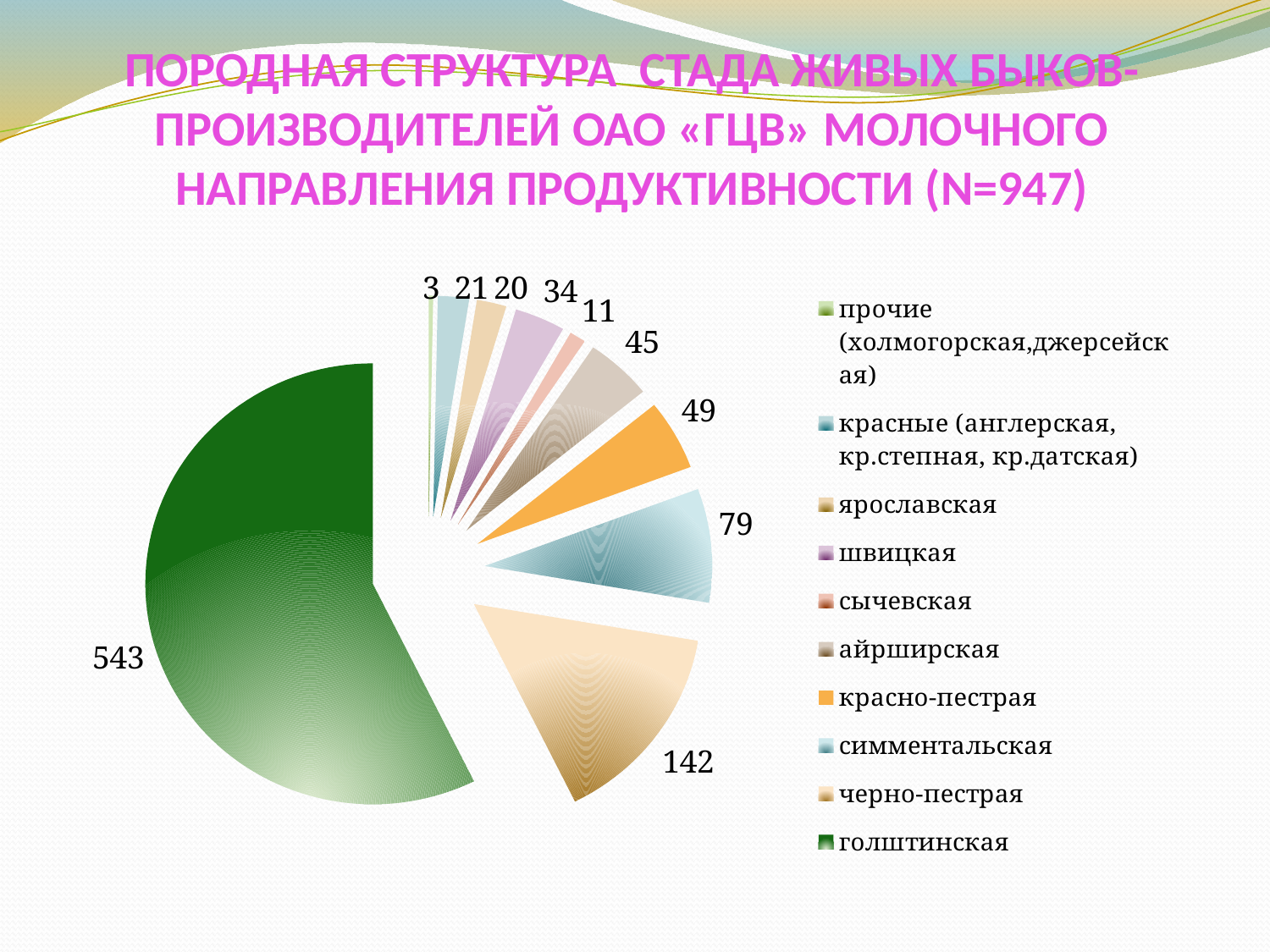
What type of chart is shown on the slide? pie chart What is the difference between the values for голштинская and черно-пестрая? 401 What is the value for красно-пестрая? 49 Which is larger, the value for симментальская or the value for айрширская? симментальская Which breed has the largest slice of the pie? голштинская Which breed has the smallest slice of the pie? прочие (холмогорская, джерсейская) What is the value for черно-пестрая? 142 What is the value for голштинская? 543 How many breed categories (slices) does the pie chart show? 10 What total number of bulls (N) is stated in the chart title? 947 What is the value for симментальская? 79 What is the value for сычевская? 11